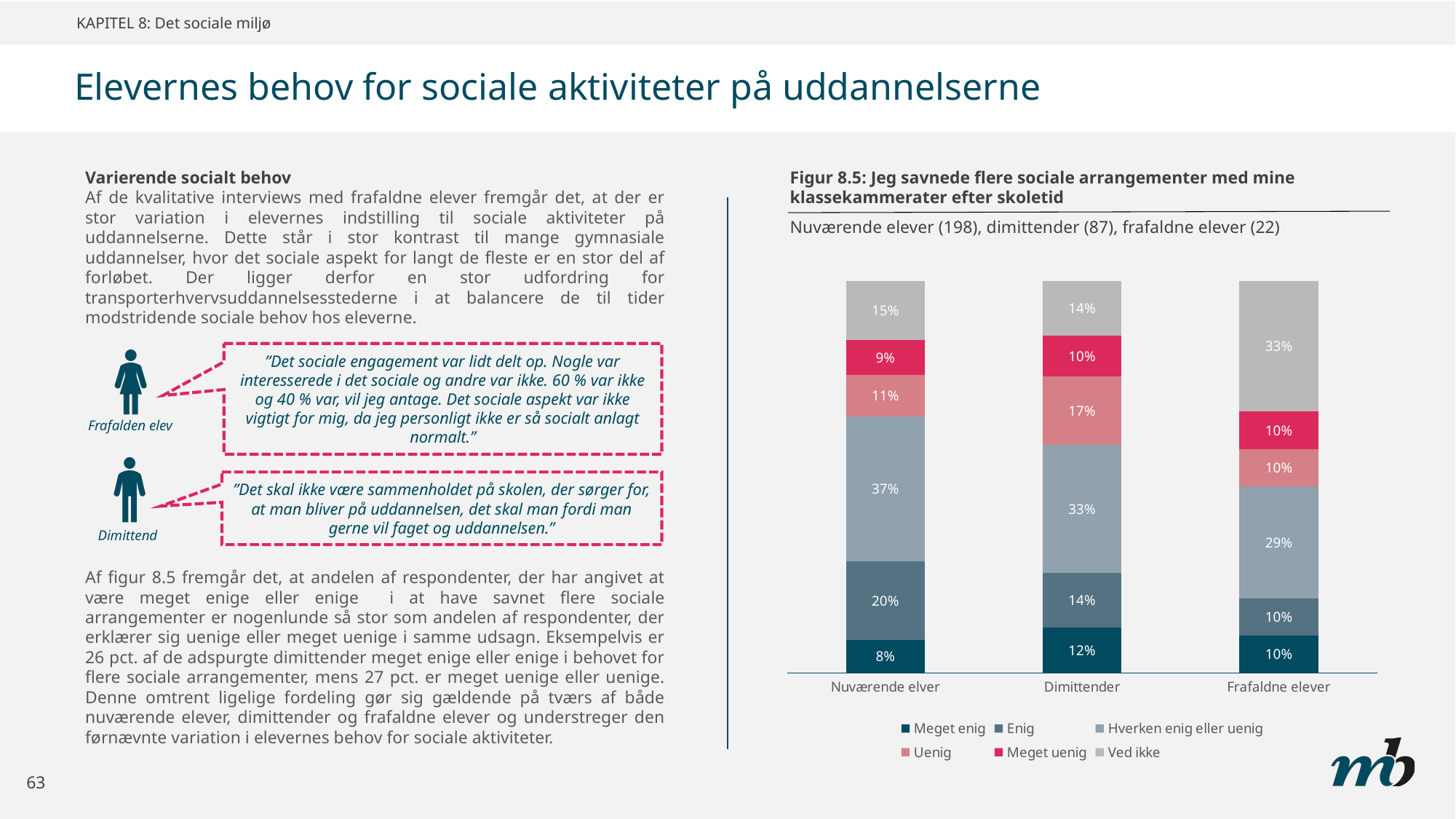
What is the total of the stacked bar for Nuværende elever? 100% What kind of chart is shown in Figur 8.5? Stacked bar chart What is the difference between the 'Enig' value for Nuværende elever and for Dimittender? 6% Which is larger: the 'Meget enig' value for Dimittender or for Nuværende elever? Dimittender What is the value for 'Meget enig' among Nuværende elever? 8% How many categories are shown on the x axis of the chart? 3 How many series does the legend of the chart list? 6 What is the value for 'Hverken enig eller uenig' among Dimittender? 33% What is the value for 'Ved ikke' among Frafaldne elever? 33% Which category has the highest value for 'Hverken enig eller uenig'? Nuværende elever What is the value for 'Uenig' among Dimittender? 17% Which category has the lowest value for 'Enig'? Frafaldne elever